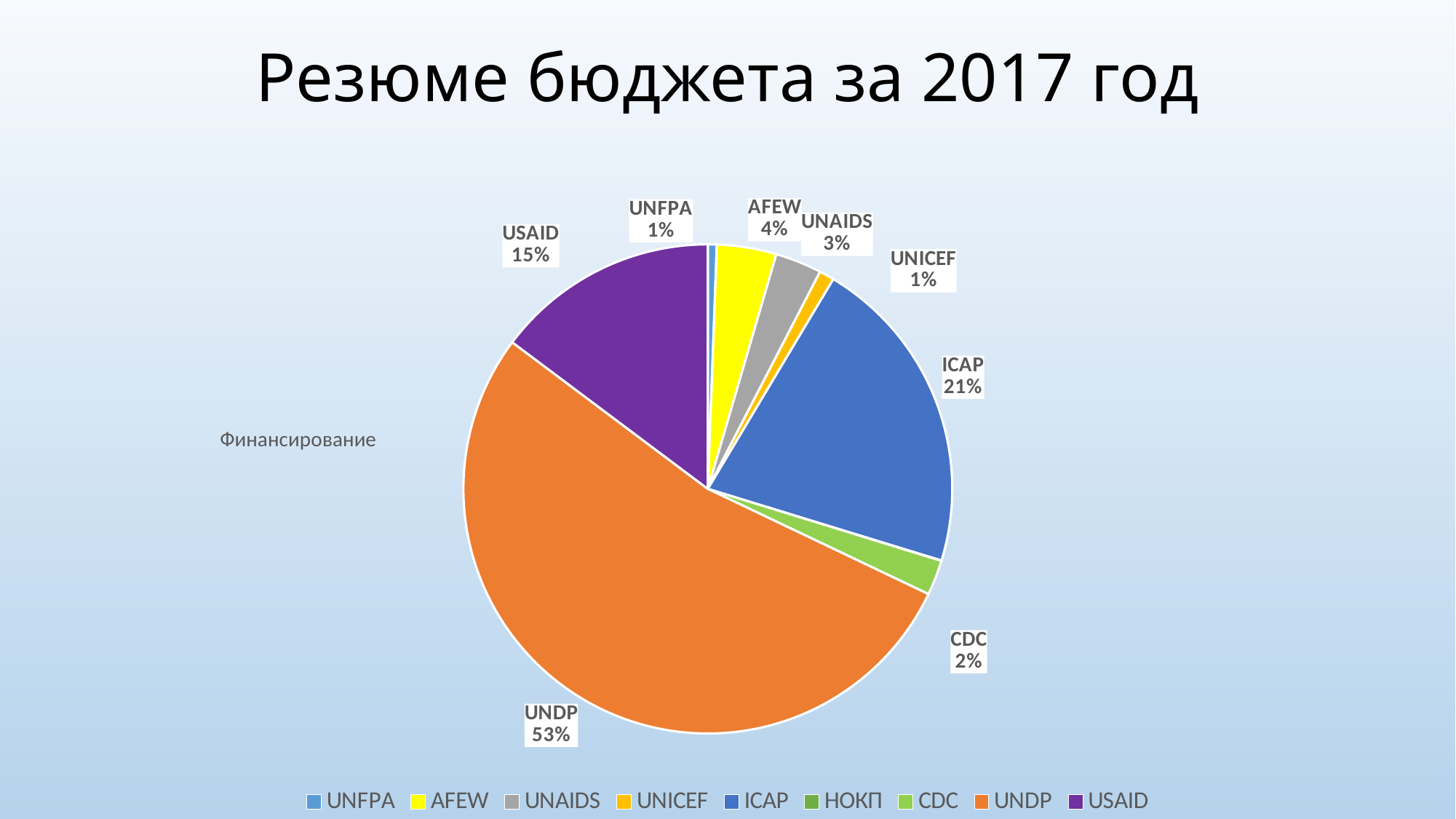
How many entries does the legend list? 9 What is the difference in percentage points between USAID and CDC? 13 What is the value shown for USAID? 15% What colour is the UNDP slice in the pie chart? Orange What is the value shown for ICAP? 21% What kind of chart is shown on the slide? Pie chart What is the value shown for AFEW? 4% Which is larger, the slice for ICAP or the slice for USAID? ICAP What share of the pie does UNDP account for? 53% What is the difference in percentage points between UNDP and ICAP? 32 Which category has the largest slice of the pie? UNDP What is the value shown for UNAIDS? 3%